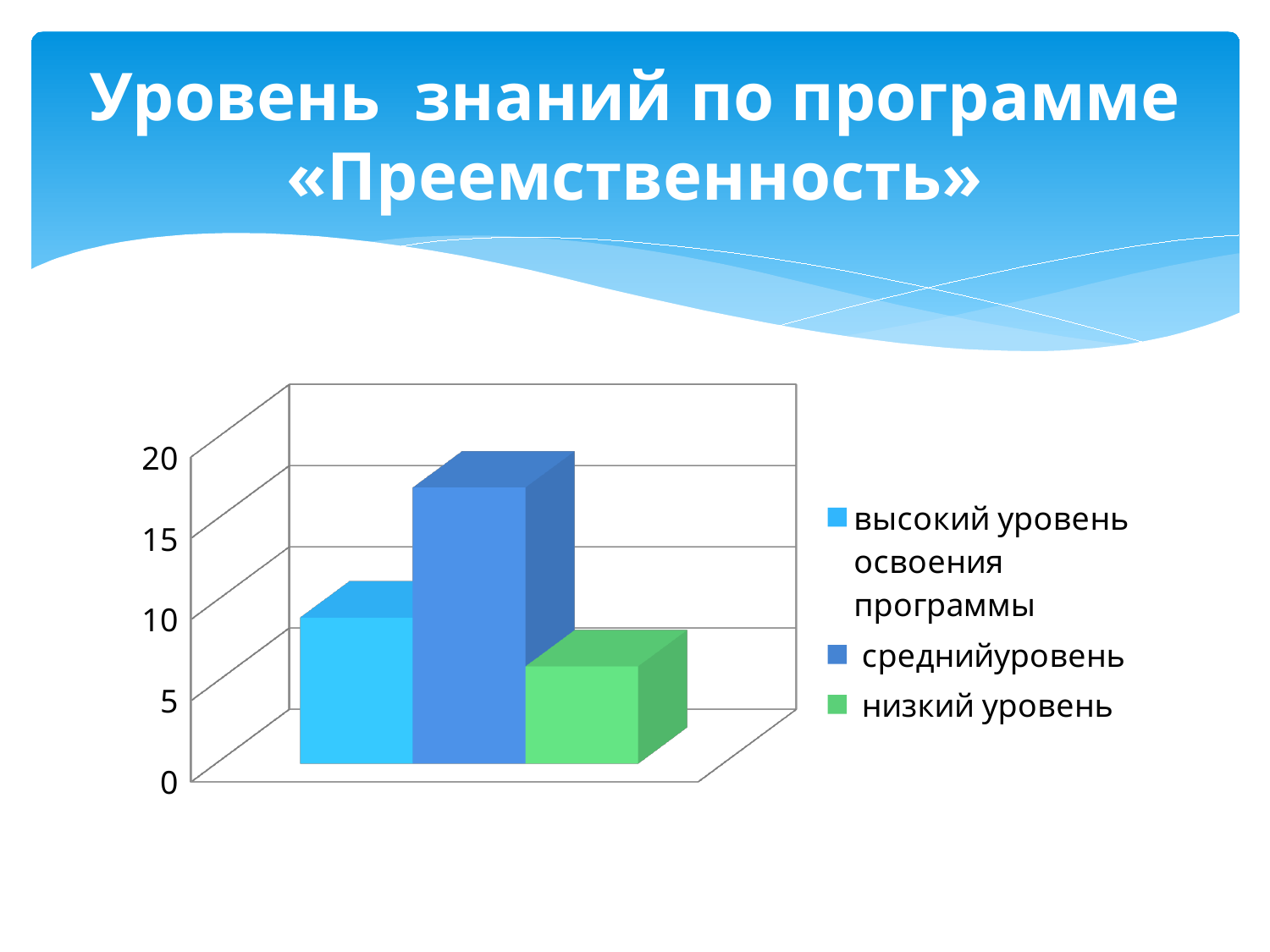
How many series does the legend list? 3 Which series has the lowest bar? низкий уровень Is the value for средний уровень greater or less than 20? less Is the value for низкий уровень greater or less than 10? less What colour is the bar for низкий уровень? green Is the value for средний уровень greater or less than 10? greater Which is larger, the bar for высокий уровень освоения программы or the bar for низкий уровень? высокий уровень освоения программы How many bars are plotted in the chart? 3 What kind of chart is shown on the slide? bar chart What is the title of the slide? Уровень знаний по программе «Преемственность» Which series has the highest bar? средний уровень